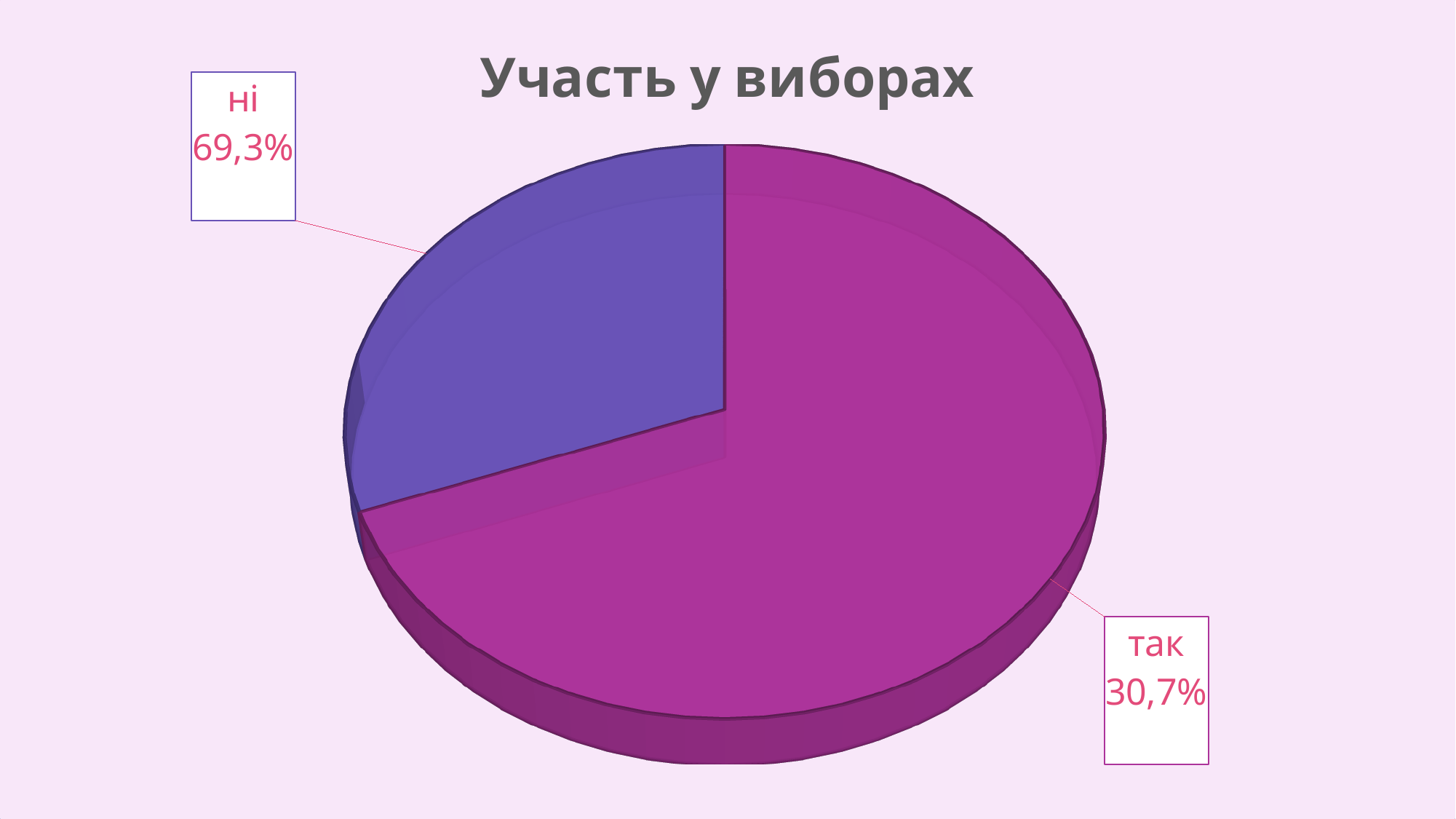
What kind of chart is shown on the slide? pie chart What is the difference between the printed percentages for "ні" and "так"? 38,6% How many slices does the pie chart have? 2 What do the two printed percentages add up to? 100% What is the title of the chart? Участь у виборах What colour is the slice labelled "так"? magenta What percentage is shown for the "так" slice? 30,7% What share of the pie is labelled for "так"? 30,7% What percentage is shown for the "ні" slice? 69,3%